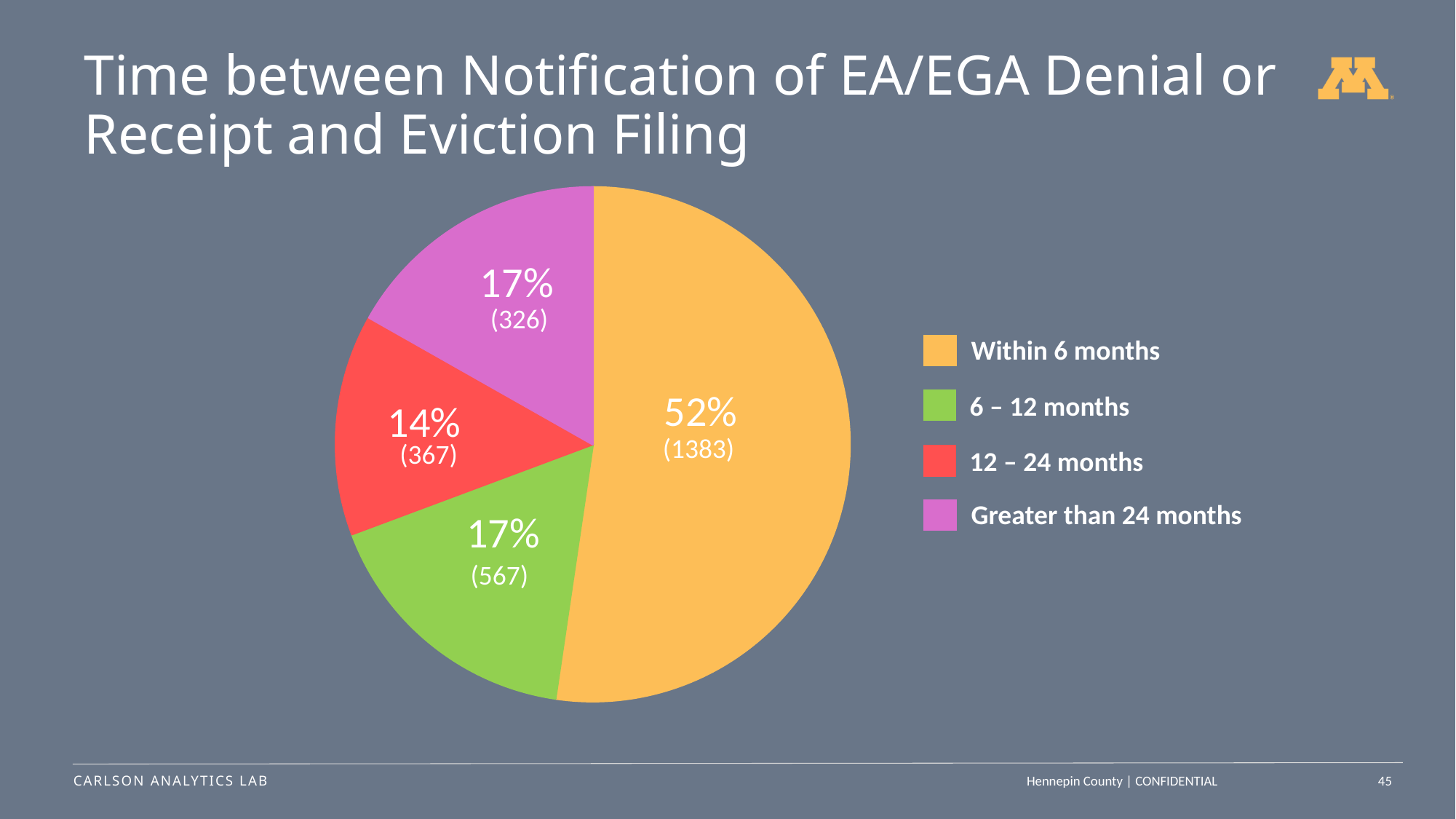
Which category has the smallest percentage share of the pie? 12 – 24 months What is the difference in count between the 'Within 6 months' slice and the '6 – 12 months' slice? 816 What colour is the 'Greater than 24 months' slice? Purple What percentage of the pie is the 'Within 6 months' slice? 52% What count is printed on the 'Within 6 months' slice? 1383 Which category has the largest share of the pie? Within 6 months What percentage is shown for the '12 – 24 months' slice? 14% What count is printed on the '6 – 12 months' slice? 567 What count is printed on the 'Greater than 24 months' slice? 326 How many slices does the pie chart have? 4 What kind of chart is shown on the slide? Pie chart Which has a larger count, '12 – 24 months' or 'Greater than 24 months'? 12 – 24 months